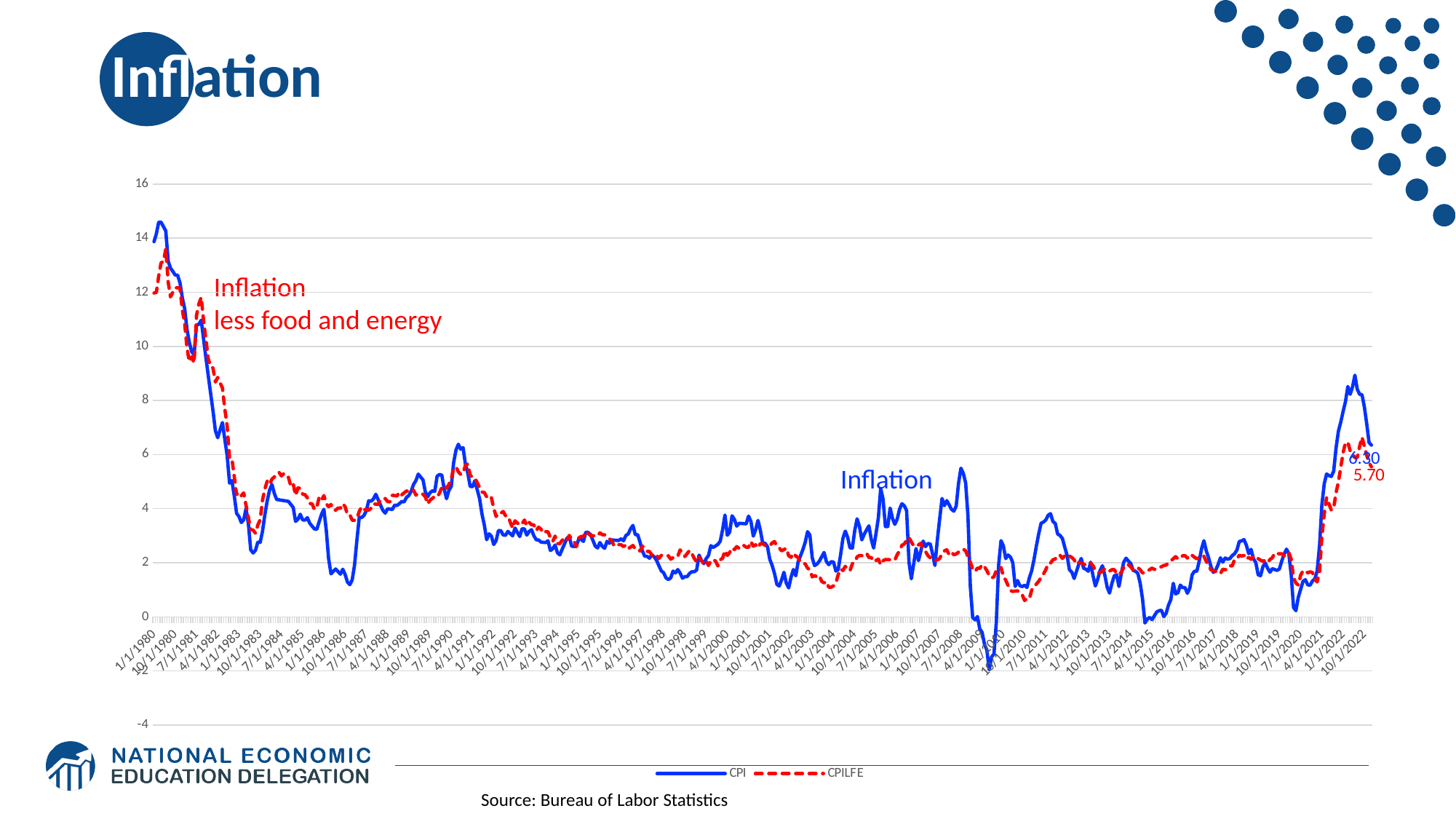
Which series is drawn as a red dashed line? CPILFE What is the final labelled value of the CPILFE series? 5.70 Is the lowest CPI value around 2009 greater or less than 0? less What is the final labelled value of the CPI series? 6.30 Is the peak CPI value in 2022 greater or less than 8? greater What are the two series named in the legend? CPI and CPILFE Is the CPI value at 1/1/1980 greater or less than 12? greater What kind of chart is shown on the slide? line chart At the end of the series, which is larger, CPI or CPILFE? CPI What is the difference between the final labelled CPI value and the final labelled CPILFE value? 0.60 How many series does the legend list? 2 Does the CPI series rise or fall between 1/1/1980 and 1/1/1983? fall